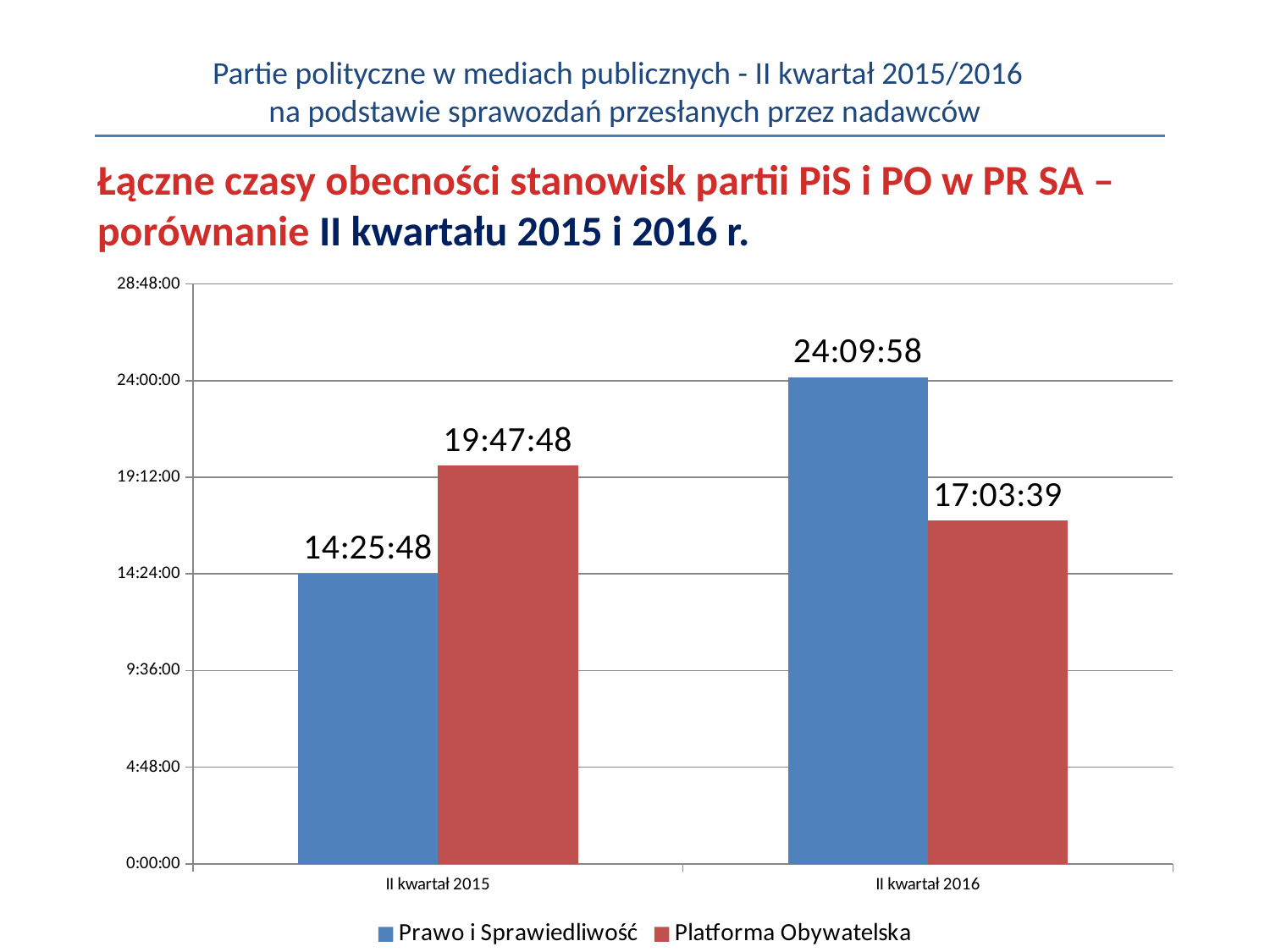
Which bar has the lowest value on the chart? Prawo i Sprawiedliwość, II kwartał 2015 What is the difference between Prawo i Sprawiedliwość and Platforma Obywatelska in II kwartał 2016? 7:06:19 What is the value for Prawo i Sprawiedliwość in II kwartał 2016? 24:09:58 What is the difference between Platforma Obywatelska and Prawo i Sprawiedliwość in II kwartał 2015? 5:22:00 What kind of chart is shown on the slide? bar chart Does the value for Platforma Obywatelska rise or fall from II kwartał 2015 to II kwartał 2016? fall Which bar has the highest value on the chart? Prawo i Sprawiedliwość, II kwartał 2016 How many series does the legend list? 2 In II kwartał 2015, which party has the larger value, Prawo i Sprawiedliwość or Platforma Obywatelska? Platforma Obywatelska What is the value for Prawo i Sprawiedliwość in II kwartał 2015? 14:25:48 What is the value for Platforma Obywatelska in II kwartał 2016? 17:03:39 Is the value for Platforma Obywatelska in II kwartał 2016 greater or less than 19:12:00? less